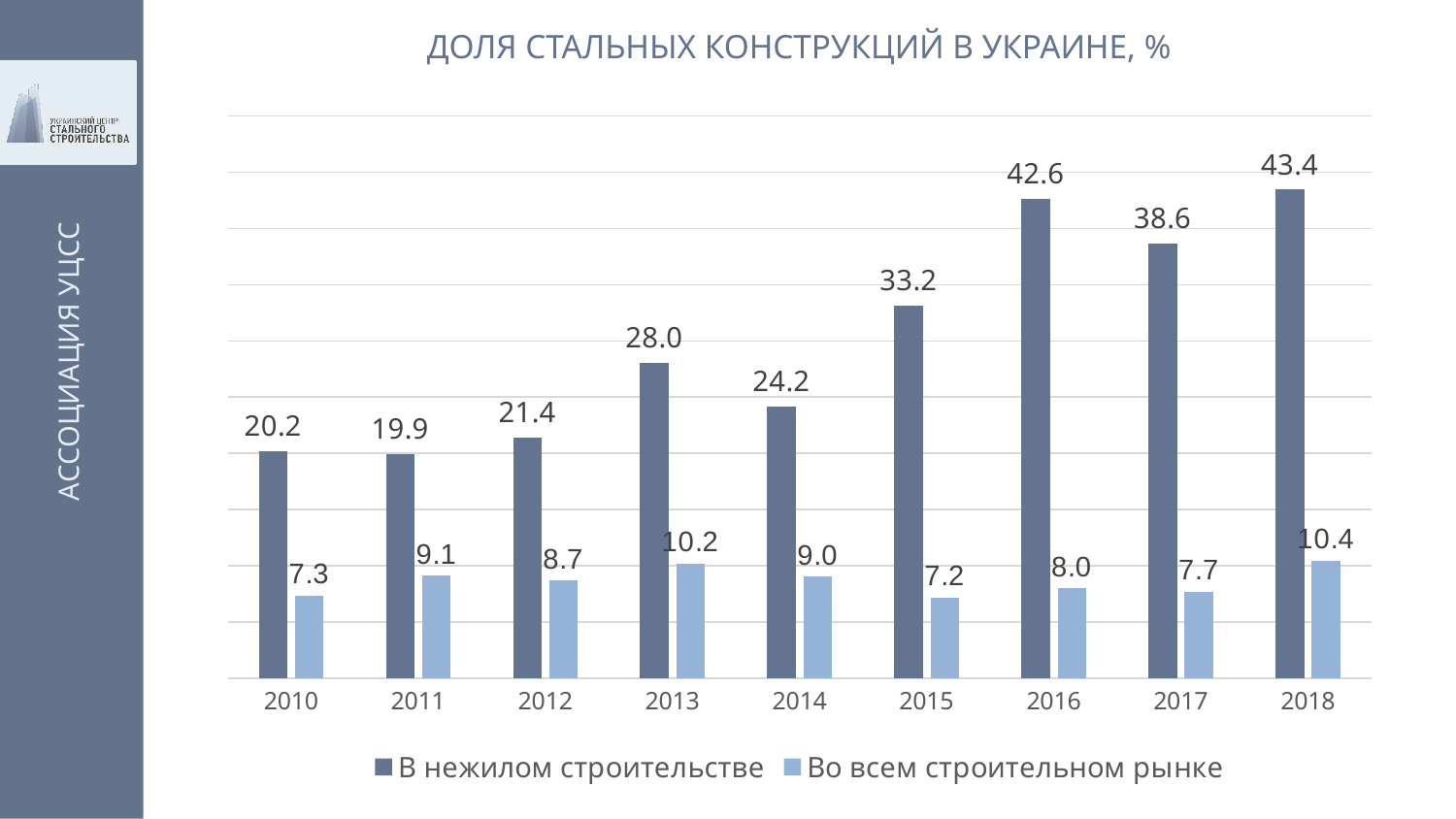
Does the 'В нежилом строительстве' series rise or fall from 2016 to 2017? fall What is the difference between the 'В нежилом строительстве' values for 2018 and 2010? 23.2 What kind of chart is shown on the slide? bar chart Which year has the lowest value for 'Во всем строительном рынке'? 2015 How many years are shown on the x axis? 9 Which series is shown in the darker bars? В нежилом строительстве What is the value for 'Во всем строительном рынке' in 2013? 10.2 How many series does the legend list? 2 What is the title of the chart? ДОЛЯ СТАЛЬНЫХ КОНСТРУКЦИЙ В УКРАИНЕ, % What is the value for 'В нежилом строительстве' in 2016? 42.6 Which is larger: the 'Во всем строительном рынке' value for 2011 or for 2014? 2011 Which year has the highest value for 'В нежилом строительстве'? 2018